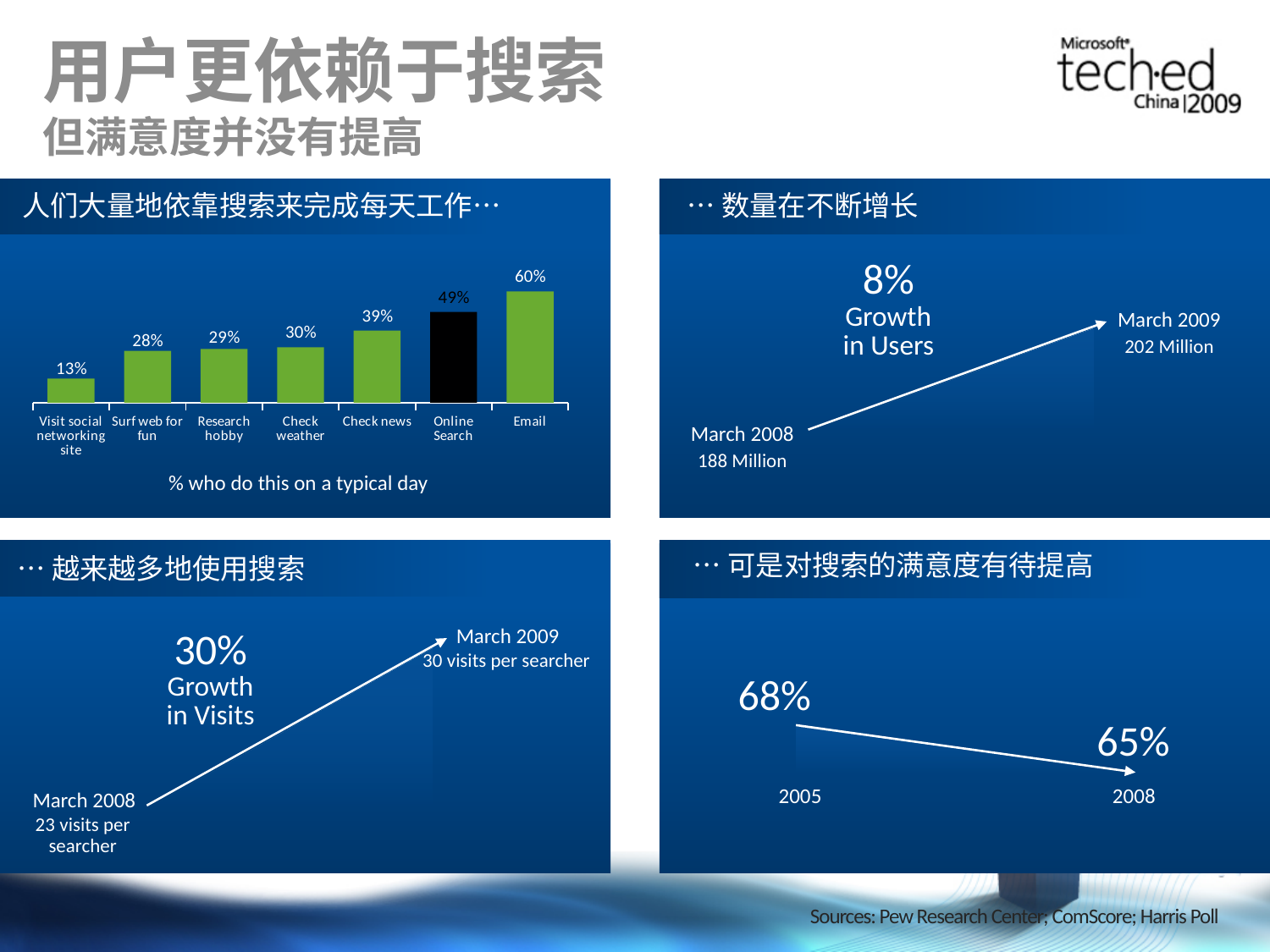
What type of chart is shown in the top-left panel? Bar chart In the bar chart in the top-left panel, how much higher is Online Search than Visit social networking site? 36% In the bar chart in the top-left panel, what percentage is shown for Online Search? 49% In the bar chart in the top-left panel, which category's bar is coloured black instead of green? Online Search In the bar chart in the top-left panel, what is the difference between the Email value and the Online Search value? 11% In the bar chart in the top-left panel, which is larger: Check news or Surf web for fun? Check news How many activity categories are shown in the bar chart in the top-left panel? 7 In the bar chart in the top-left panel, what is the value for Surf web for fun? 28% In the bar chart in the top-left panel, what is the value for Check news? 39% In the bar chart in the top-left panel, do the values rise or fall from left to right? Rise In the bar chart in the top-left panel, which activity has the lowest percentage? Visit social networking site In the bar chart in the top-left panel, which activity has the highest percentage? Email